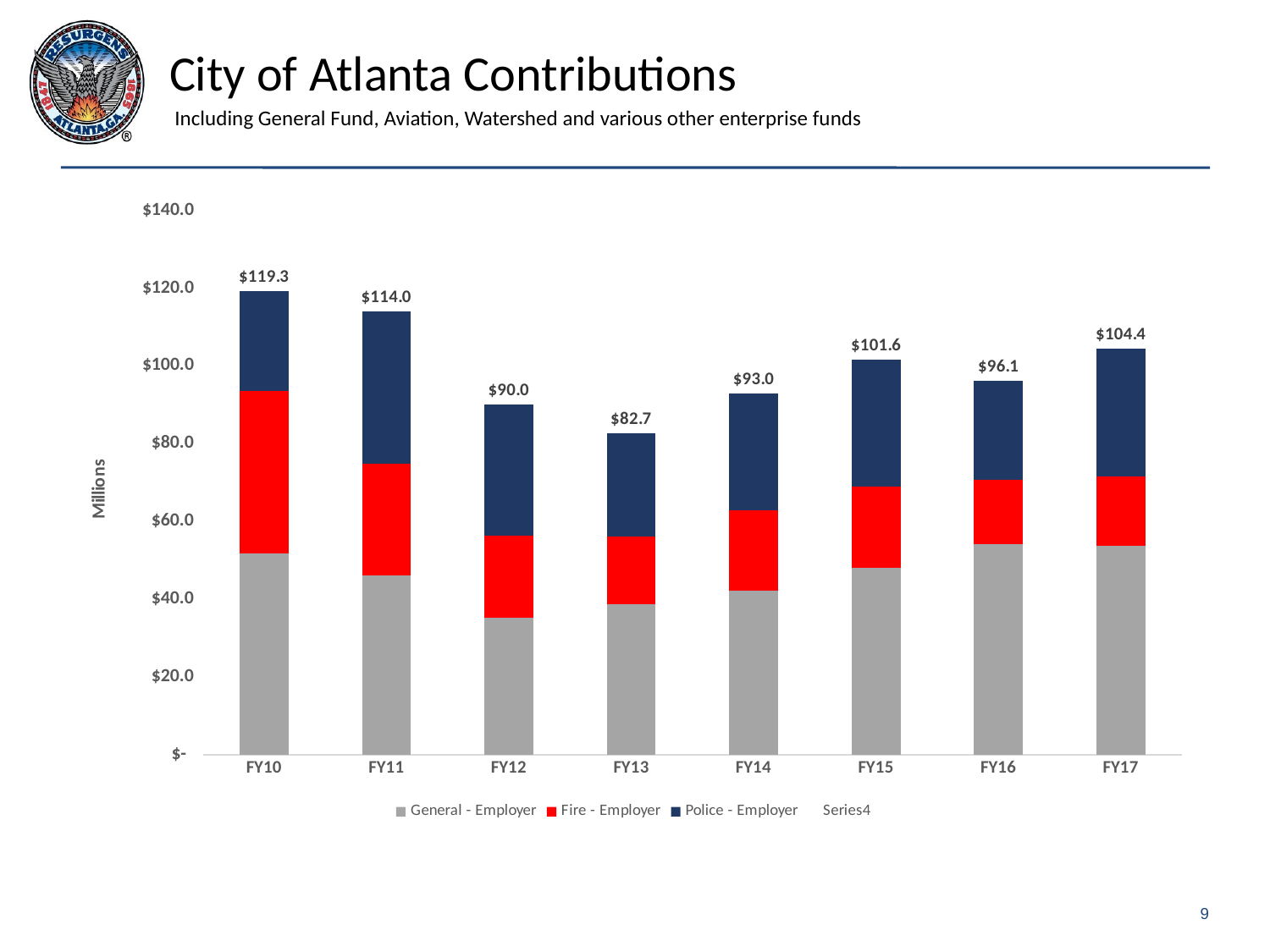
What is the total contribution shown for FY15? $101.6 Do the total contributions rise or fall from FY10 to FY13? Fall What is the total contribution shown for FY10? $119.3 How many fiscal years are shown on the x axis? 8 Which fiscal year has the lowest total contribution? FY13 What kind of chart is shown on the slide? Stacked bar chart Is the value for General - Employer in FY10 greater or less than $40.0? greater How many series does the legend list? 4 Which fiscal year has a larger total contribution, FY14 or FY16? FY16 What is the difference between the total contributions for FY10 and FY11? $5.3 Which fiscal year has the highest total contribution? FY10 Is the value for General - Employer in FY12 greater or less than $40.0? less